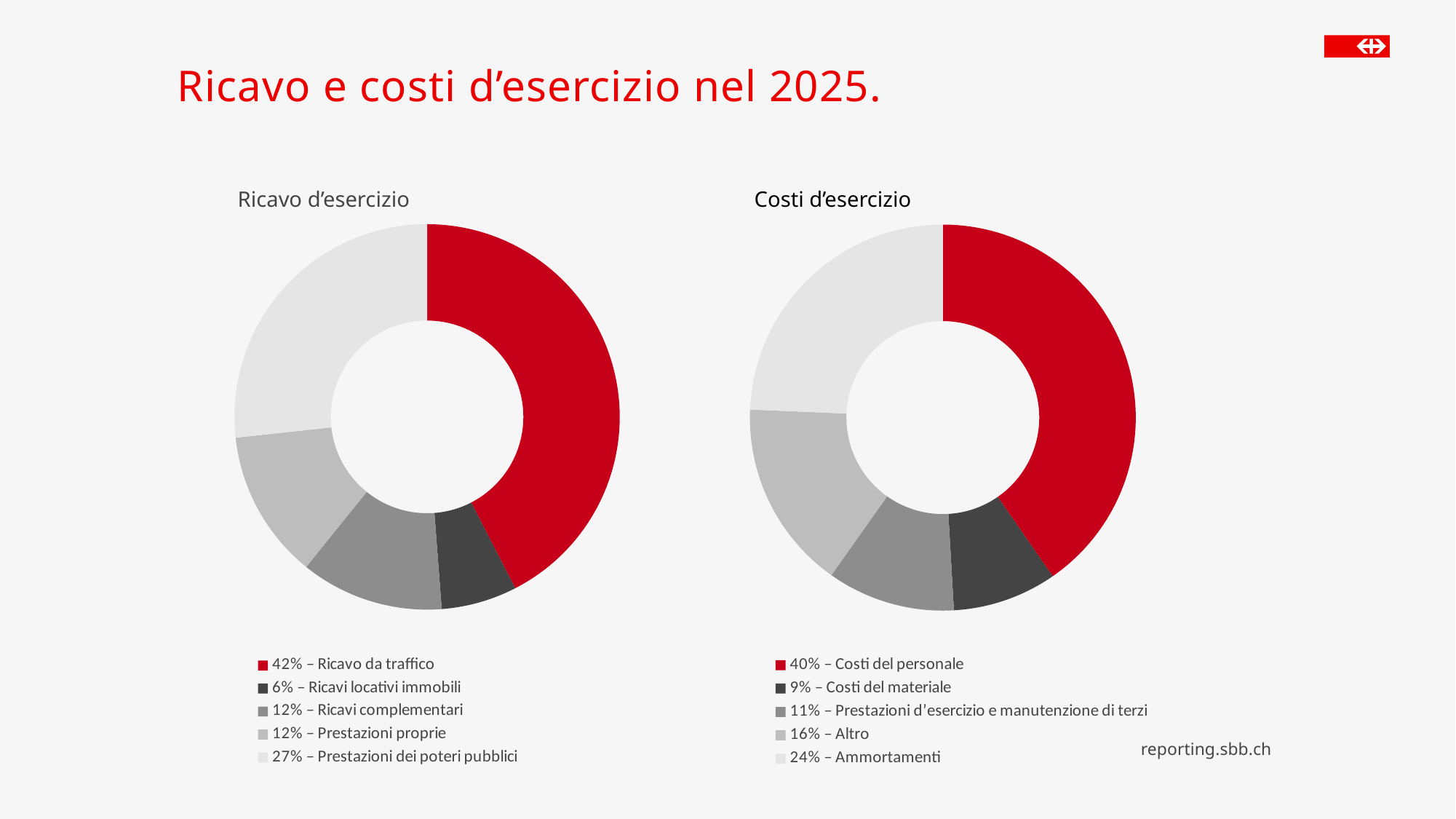
In the 'Ricavo d'esercizio' chart, what is the difference between 'Ricavo da traffico' and 'Prestazioni dei poteri pubblici'? 15% What kind of chart is the 'Ricavo d'esercizio' chart? Doughnut chart What is the title of the chart on the left of the slide? Ricavo d'esercizio In the 'Costi d'esercizio' chart, what share is 'Ammortamenti'? 24% In the 'Ricavo d'esercizio' chart, which is larger: 'Prestazioni dei poteri pubblici' or 'Ricavi complementari'? Prestazioni dei poteri pubblici In the 'Ricavo d'esercizio' chart, what share is 'Ricavo da traffico'? 42% In the 'Costi d'esercizio' chart, what share is 'Prestazioni d'esercizio e manutenzione di terzi'? 11% In the 'Costi d'esercizio' chart, what is the difference between 'Costi del personale' and 'Ammortamenti'? 16% In the 'Ricavo d'esercizio' chart, which category has the smallest share? Ricavi locativi immobili In the 'Costi d'esercizio' chart, which is larger: 'Altro' or 'Costi del materiale'? Altro In the 'Costi d'esercizio' chart, which category has the largest share? Costi del personale How many categories does the 'Costi d'esercizio' chart show? 5